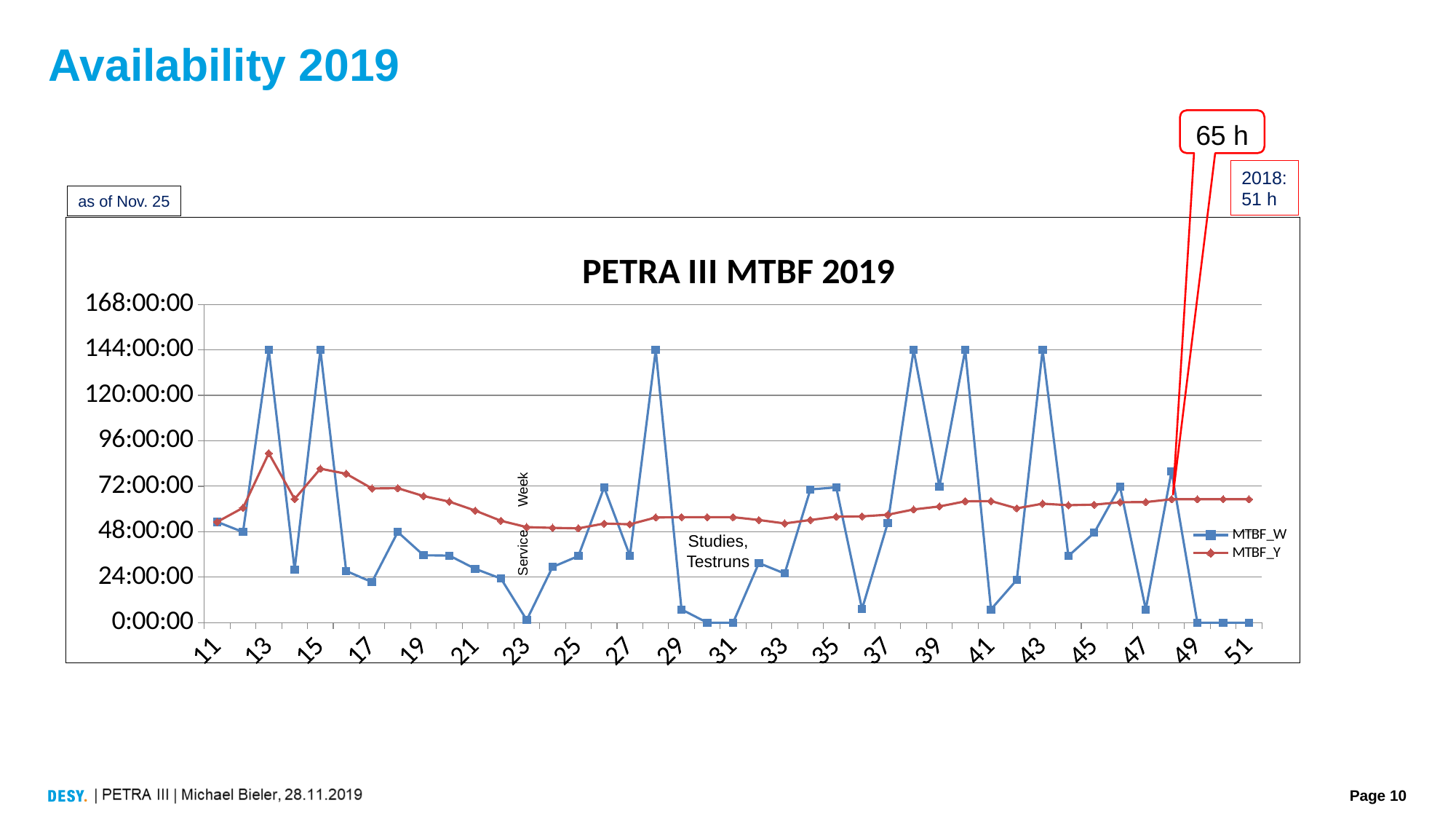
How many series does the legend of the PETRA III MTBF 2019 chart list? 2 Is the MTBF_W value at week 23 greater or less than 24:00:00? less In which week does the MTBF_Y series reach its highest value? 13 Is the MTBF_Y value at week 13 greater or less than 72:00:00? greater What MTBF value does the annotation give for 2018? 51 h What is the MTBF_W value at week 31? 0:00:00 At week 15, which series has the larger value, MTBF_W or MTBF_Y? MTBF_W What is the title of the chart? PETRA III MTBF 2019 Is the MTBF_Y value at week 31 greater or less than 72:00:00? less What kind of chart is shown on the slide? line chart What value does the red callout give for the MTBF_Y series at the end of the chart? 65 h What is the MTBF_W value at week 13? 144:00:00